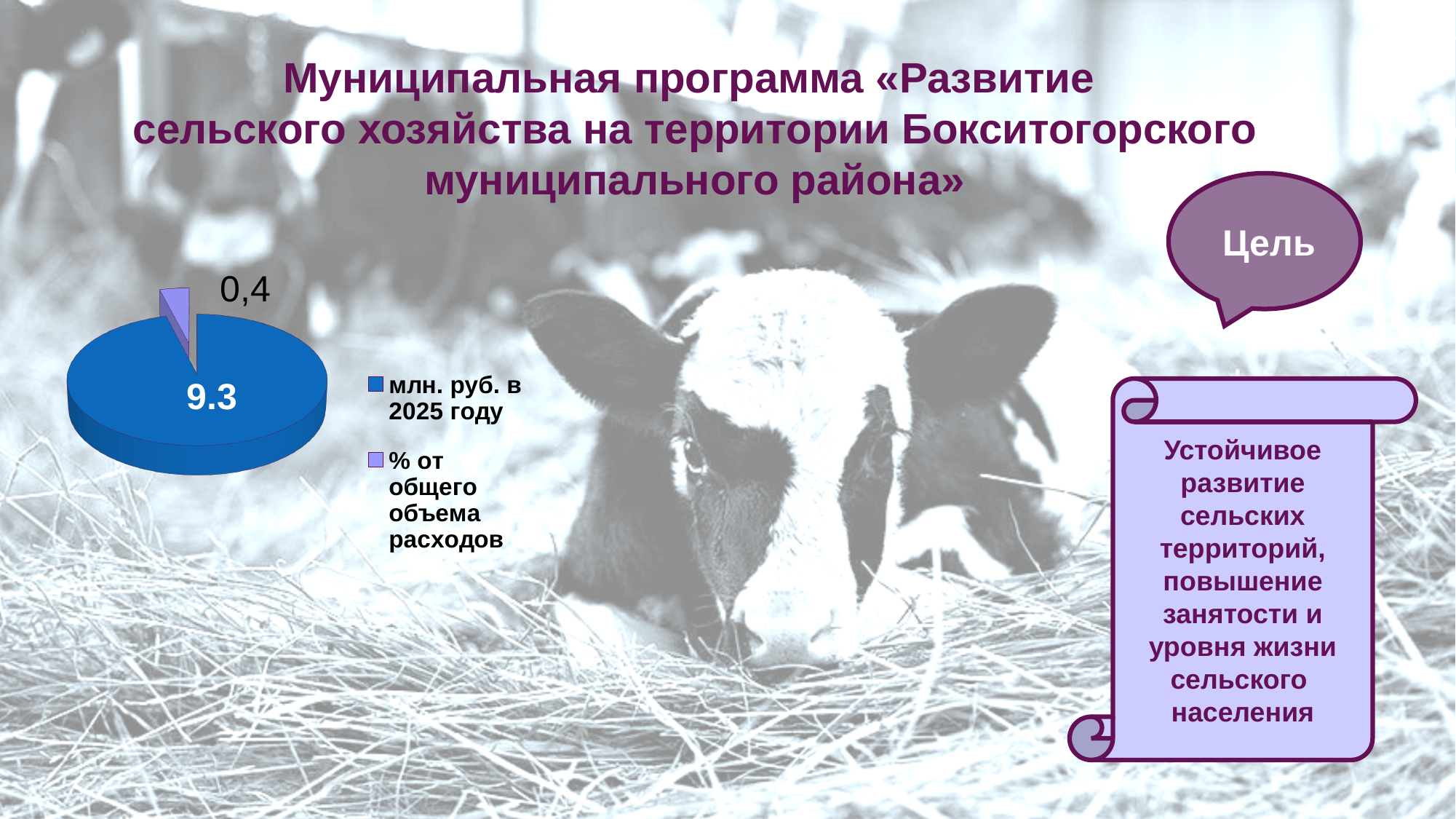
What kind of chart is shown on the slide? Pie chart What is the difference between the two values shown on the pie chart (9.3 and 0,4)? 8.9 Which slice of the pie chart is the smallest? % от общего объема расходов What value is shown for the "% от общего объема расходов" slice of the pie chart? 0,4 How many entries does the legend of the pie chart list? 2 What value is shown for the "млн. руб. в 2025 году" slice of the pie chart? 9.3 Which slice of the pie chart is the largest? млн. руб. в 2025 году What colour is the "млн. руб. в 2025 году" slice of the pie chart? Blue How many slices does the pie chart have? 2 Which is larger in the pie chart: "млн. руб. в 2025 году" or "% от общего объема расходов"? млн. руб. в 2025 году What colour is the "% от общего объема расходов" slice of the pie chart? Light purple